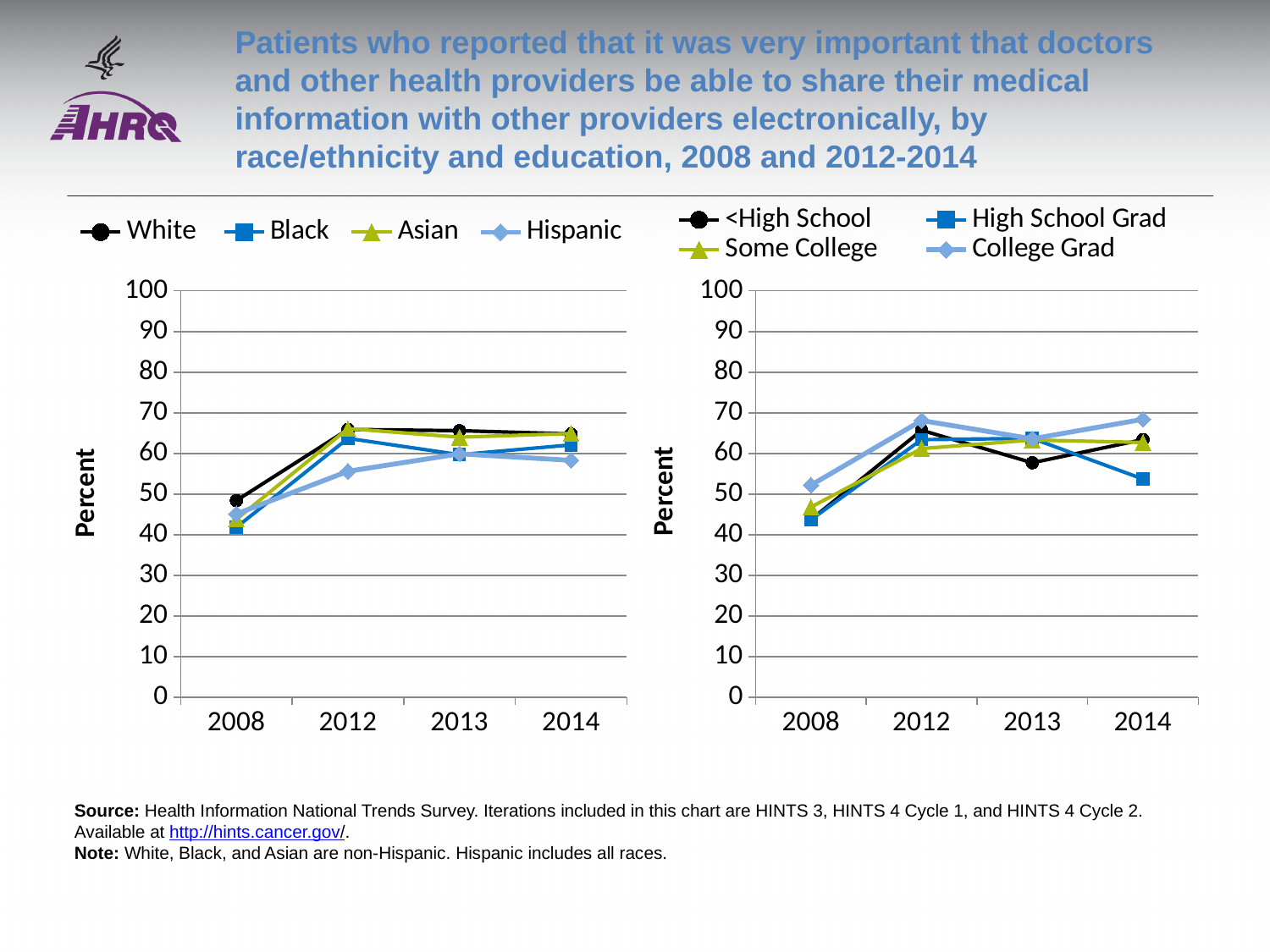
How many series does the legend of the left chart (by race/ethnicity) list? 4 In the right chart (by education), is the value for College Grad in 2008 greater or less than 50? greater In the left chart (by race/ethnicity), which is higher in 2008, White or Black? White How many years are shown on the x axis of the right chart (by education)? 4 In the left chart (by race/ethnicity), is the value for White in 2008 greater or less than 50? less How many series does the legend of the right chart (by education) list? 4 In the left chart (by race/ethnicity), which group has the lowest value in 2008? Black In the right chart (by education), is the value for High School Grad in 2014 greater or less than 60? less What kind of chart is the left chart (by race/ethnicity)? line chart In the right chart (by education), which group has the lowest value in 2013? <High School In the right chart (by education), which group has the highest value in 2014? College Grad